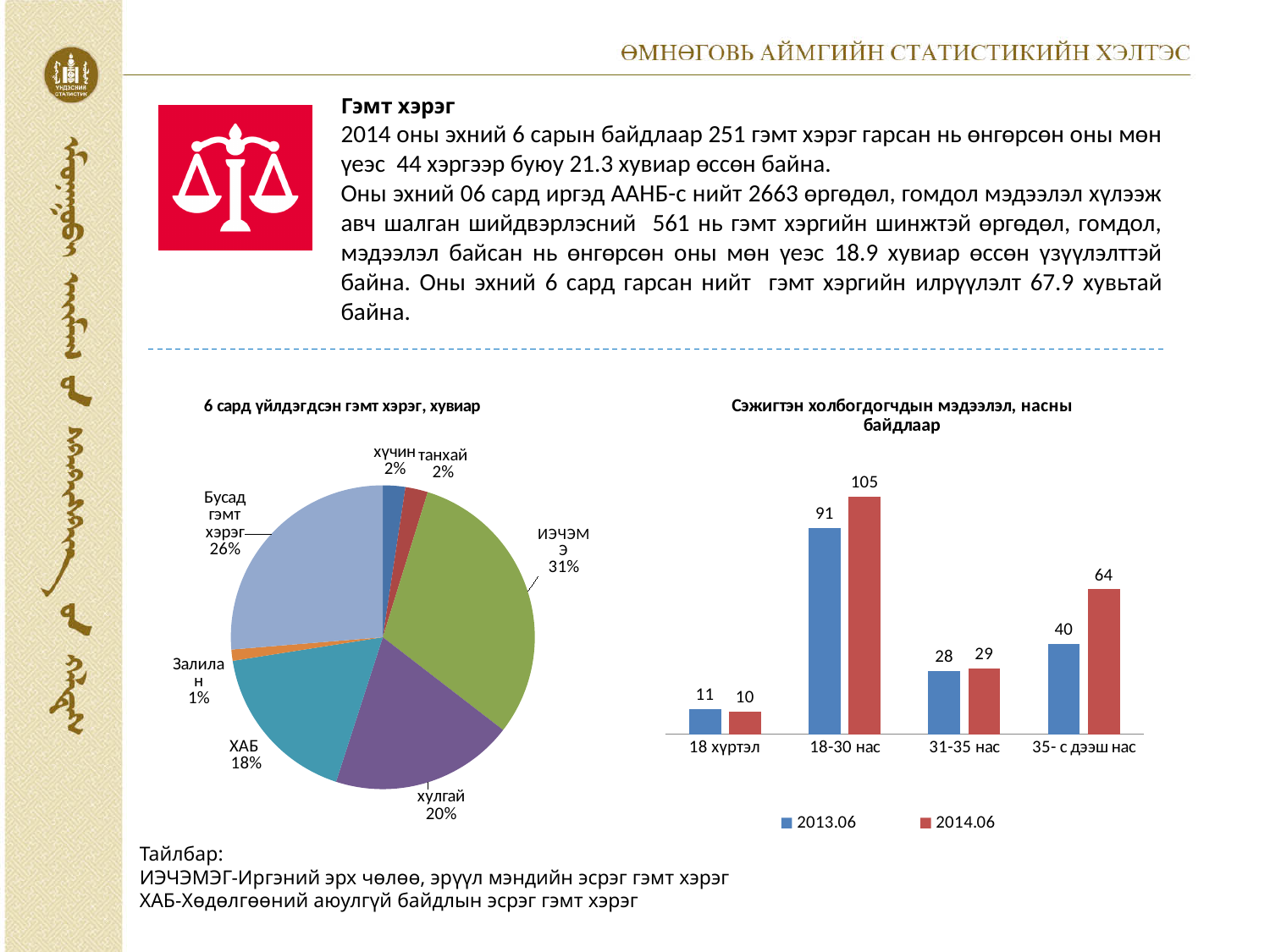
In the bar chart 'Сэжигтэн холбогдогчдын мэдээлэл, насны байдлаар', what is the difference between the 2014.06 and 2013.06 values for 35- с дээш нас? 24 How many series does the legend of the bar chart 'Сэжигтэн холбогдогчдын мэдээлэл, насны байдлаар' list? 2 In the pie chart '6 сард үйлдэгдсэн гэмт хэрэг, хувиар', what share does хулгай have? 20% In the pie chart '6 сард үйлдэгдсэн гэмт хэрэг, хувиар', which category has the largest share? ИЭЧЭМЭ In the bar chart 'Сэжигтэн холбогдогчдын мэдээлэл, насны байдлаар', which age category has the lowest value in 2013.06? 18 хүртэл In the bar chart 'Сэжигтэн холбогдогчдын мэдээлэл, насны байдлаар', what is the value for 35- с дээш нас in 2013.06? 40 In the bar chart 'Сэжигтэн холбогдогчдын мэдээлэл, насны байдлаар', what is the value for 18-30 нас in 2014.06? 105 How many slices does the pie chart '6 сард үйлдэгдсэн гэмт хэрэг, хувиар' have? 7 How many age categories are shown on the x axis of the bar chart 'Сэжигтэн холбогдогчдын мэдээлэл, насны байдлаар'? 4 In the bar chart 'Сэжигтэн холбогдогчдын мэдээлэл, насны байдлаар', which is larger for 18 хүртэл: the 2013.06 value or the 2014.06 value? 2013.06 What kind of chart is the chart on the right titled 'Сэжигтэн холбогдогчдын мэдээлэл, насны байдлаар'? bar chart In the bar chart 'Сэжигтэн холбогдогчдын мэдээлэл, насны байдлаар', which age category has the highest value in 2014.06? 18-30 нас